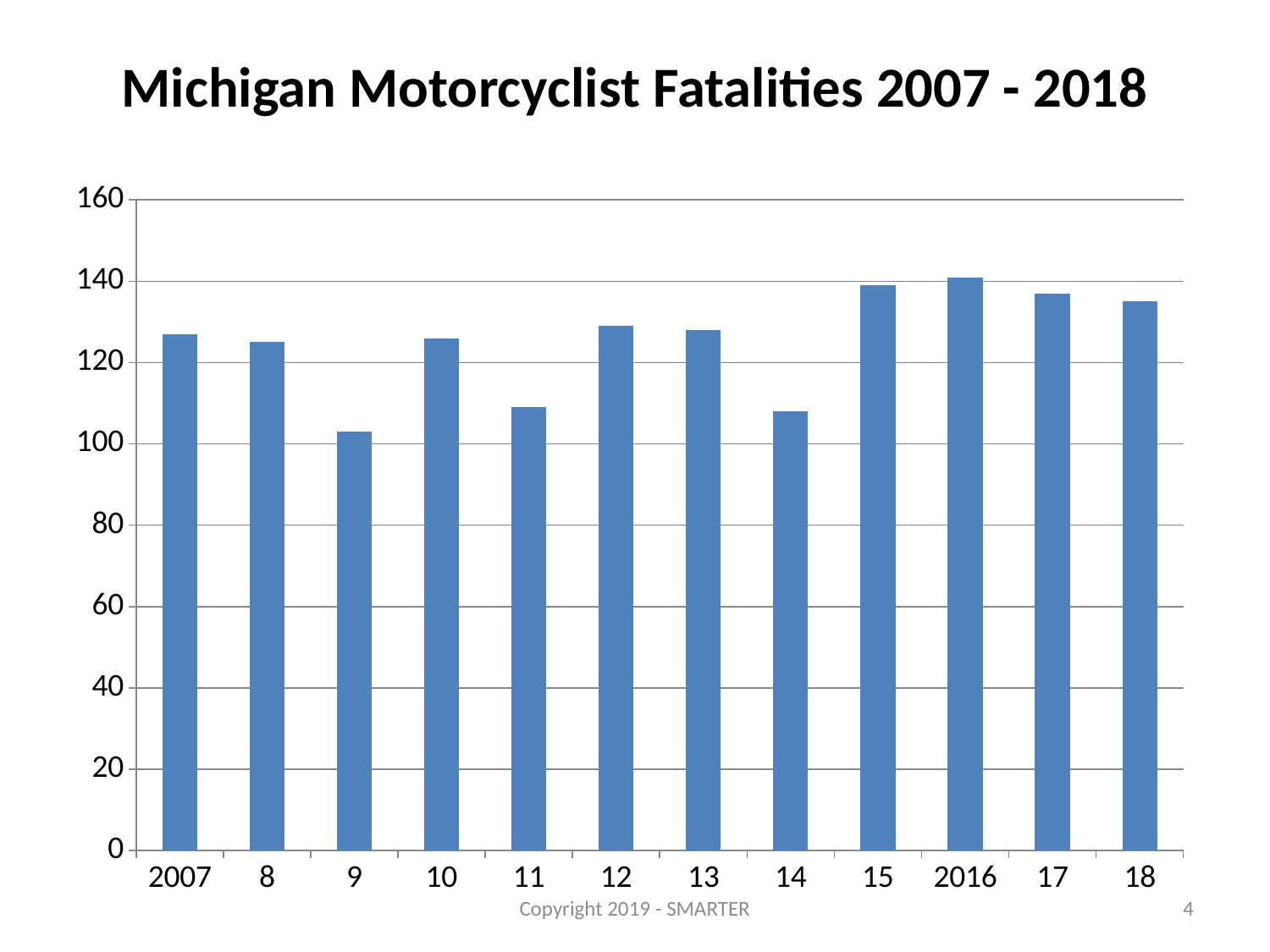
Is the value for 15 greater or less than 120? greater What kind of chart is shown on the slide? bar chart Is the value for 2007 greater or less than 100? greater Is the value for 14 greater or less than 120? less Which is larger, the value for 14 or the value for 15? 15 Does the value rise or fall from 14 to 15? rise Which is larger, the value for 9 or the value for 2007? 2007 Which year has the highest bar in the chart? 2016 What is the title of the chart? Michigan Motorcyclist Fatalities 2007 - 2018 Which year has the lowest bar in the chart? 9 How many bars (years) are plotted in the chart? 12